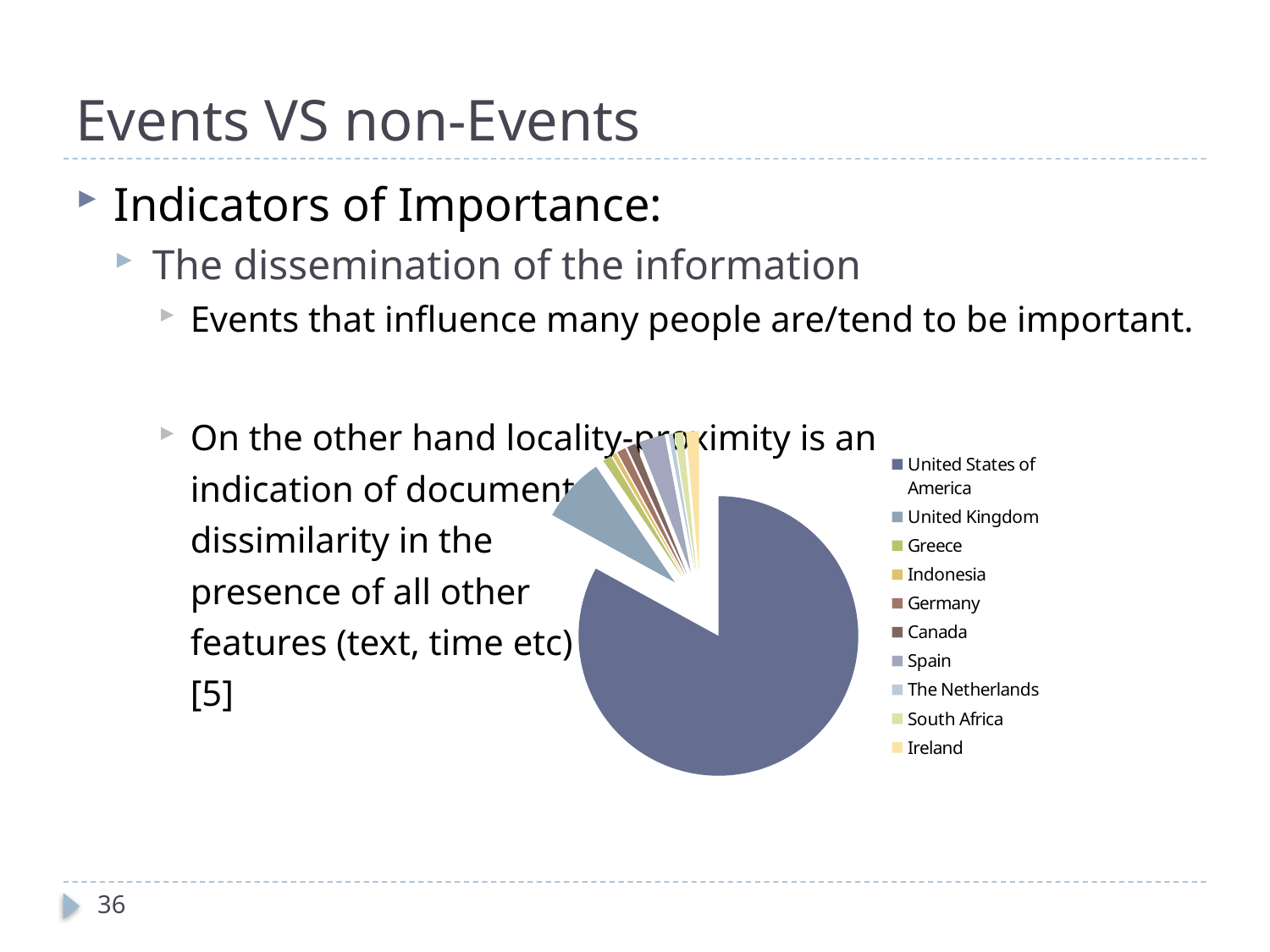
How many categories does the pie chart's legend list? 10 What kind of chart is shown on the slide? pie chart Which category has the largest slice in the pie chart? United States of America Which category is listed last in the pie chart's legend? Ireland Which slice is larger in the pie chart, United States of America or United Kingdom? United States of America Which category has the second-largest slice in the pie chart? United Kingdom Which category is listed first in the pie chart's legend? United States of America Is the slice for United States of America larger than half of the pie? Yes Does the pie chart's legend include Canada? Yes Which slice is larger in the pie chart, United Kingdom or Greece? United Kingdom